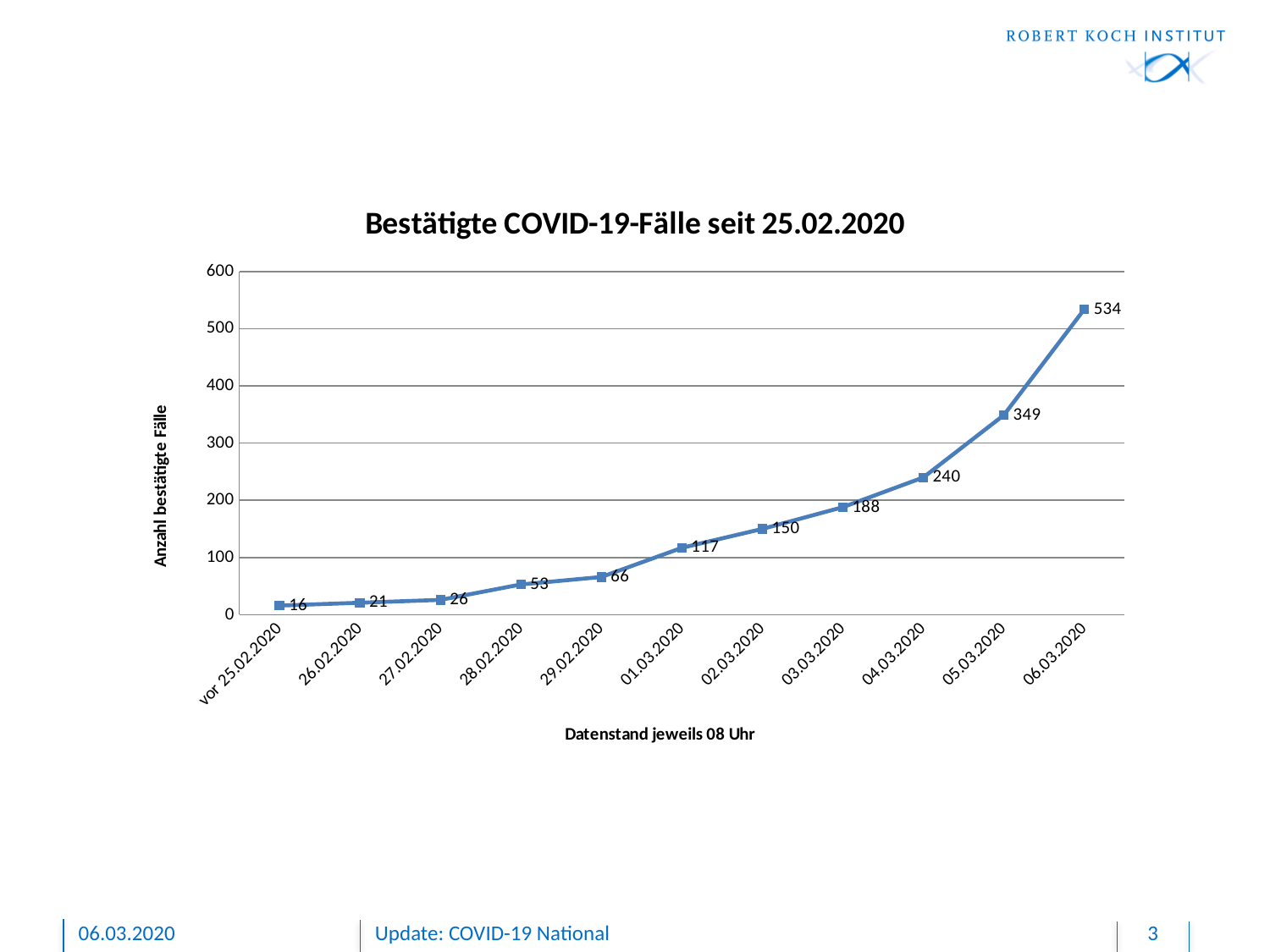
What kind of chart is shown on the slide? line chart Which date has the highest number of confirmed cases? 06.03.2020 Which date has the lowest number of confirmed cases? vor 25.02.2020 What is the value for 01.03.2020? 117 How many data points are plotted on the chart? 11 What is the difference between the values for 06.03.2020 and 05.03.2020? 185 What is the value for 06.03.2020? 534 Is the value for 04.03.2020 greater or less than 200? greater Which is larger, the value for 03.03.2020 or the value for 02.03.2020? 03.03.2020 What is the title of the chart? Bestätigte COVID-19-Fälle seit 25.02.2020 What is the value for vor 25.02.2020? 16 Do the values rise or fall along the x axis? rise